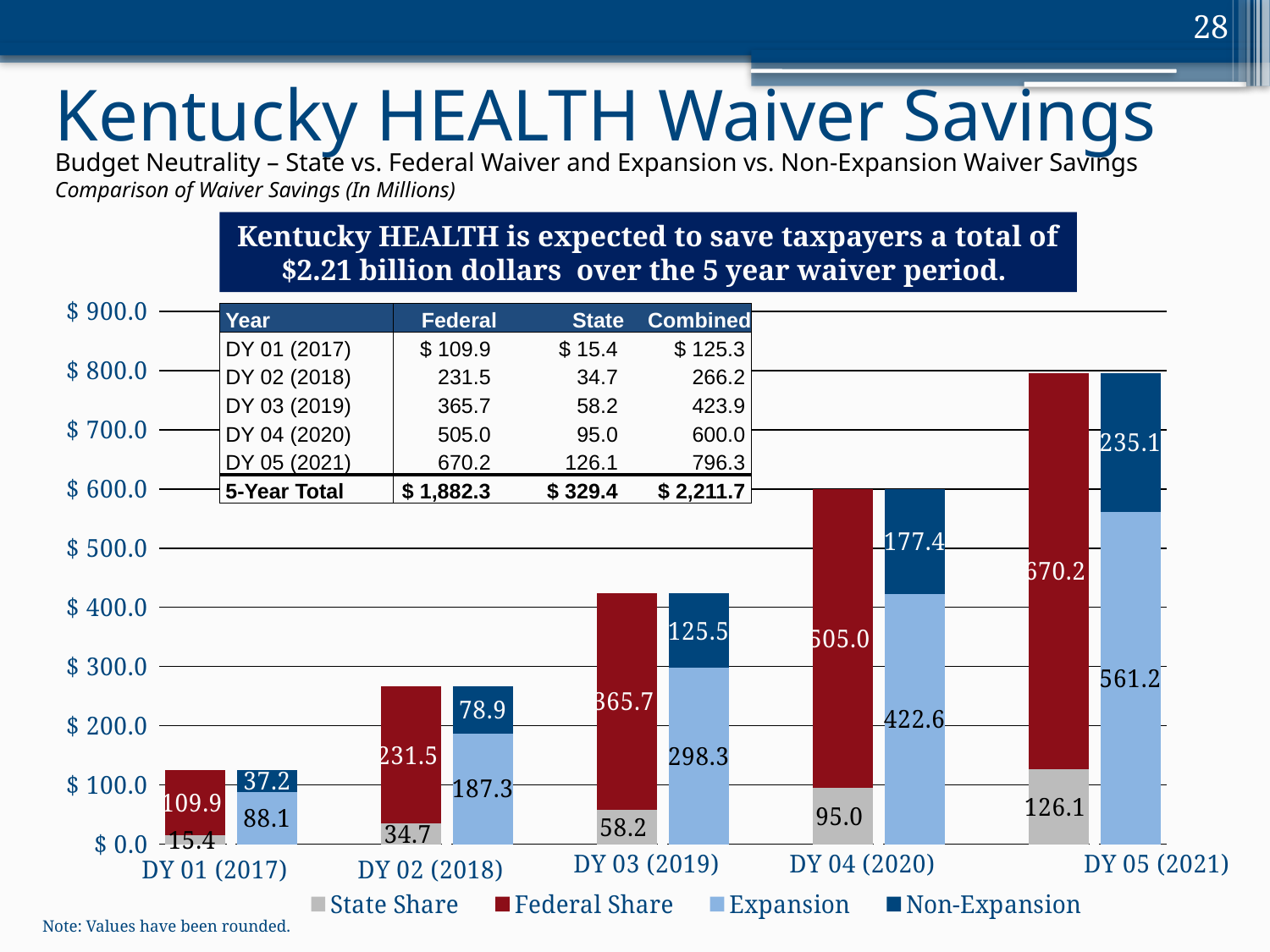
What is the Federal Share value for DY 03 (2019)? 365.7 Which is larger for DY 03 (2019): the Expansion value or the Non-Expansion value? Expansion How many years are shown on the x axis of the chart? 5 How many series does the chart legend list? 4 What is the difference between the Federal Share for DY 05 (2021) and DY 04 (2020)? 165.2 What is the Expansion value for DY 05 (2021)? 561.2 Which year has the highest Federal Share? DY 05 (2021) What is the Non-Expansion value for DY 02 (2018)? 78.9 What is the total of the Expansion and Non-Expansion stacked bar for DY 05 (2021)? 796.3 Which year has the lowest State Share? DY 01 (2017) What kind of chart is shown on the slide? Stacked bar chart What is the State Share value for DY 04 (2020)? 95.0